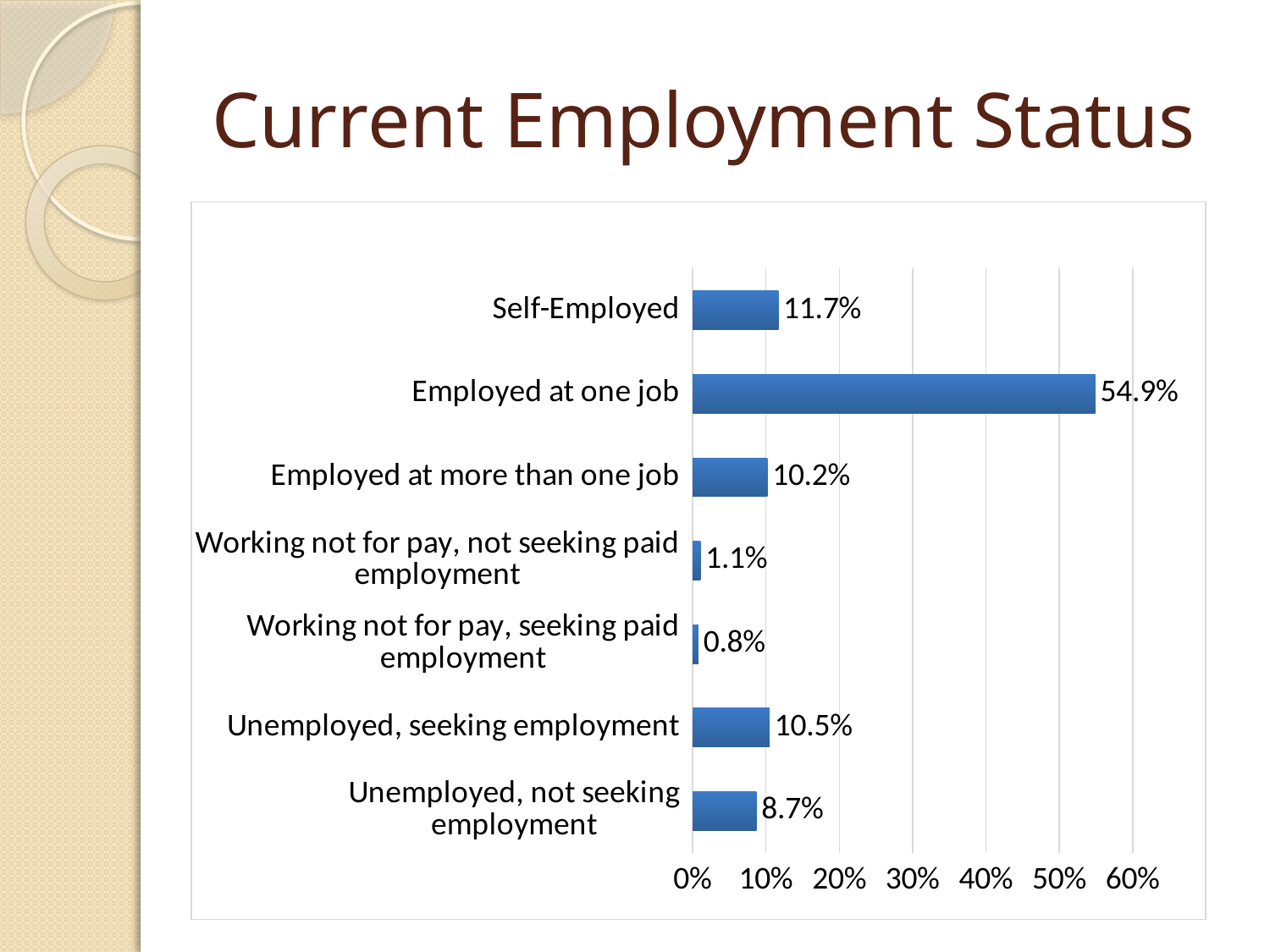
Which category has the highest value? Employed at one job Is the value for Employed at one job greater or less than 50%? greater What is the value for Working not for pay, seeking paid employment? 0.8% What is the value for Employed at one job? 54.9% What kind of chart is shown on the slide? Bar chart Which is larger, Self-Employed or Unemployed, not seeking employment? Self-Employed What is the value for Unemployed, not seeking employment? 8.7% How many categories are shown in the chart? 7 Which category has the lowest value? Working not for pay, seeking paid employment What is the difference between Employed at one job and Self-Employed? 43.2% What is the difference between Unemployed, seeking employment and Employed at more than one job? 0.3% What is the value for Self-Employed? 11.7%